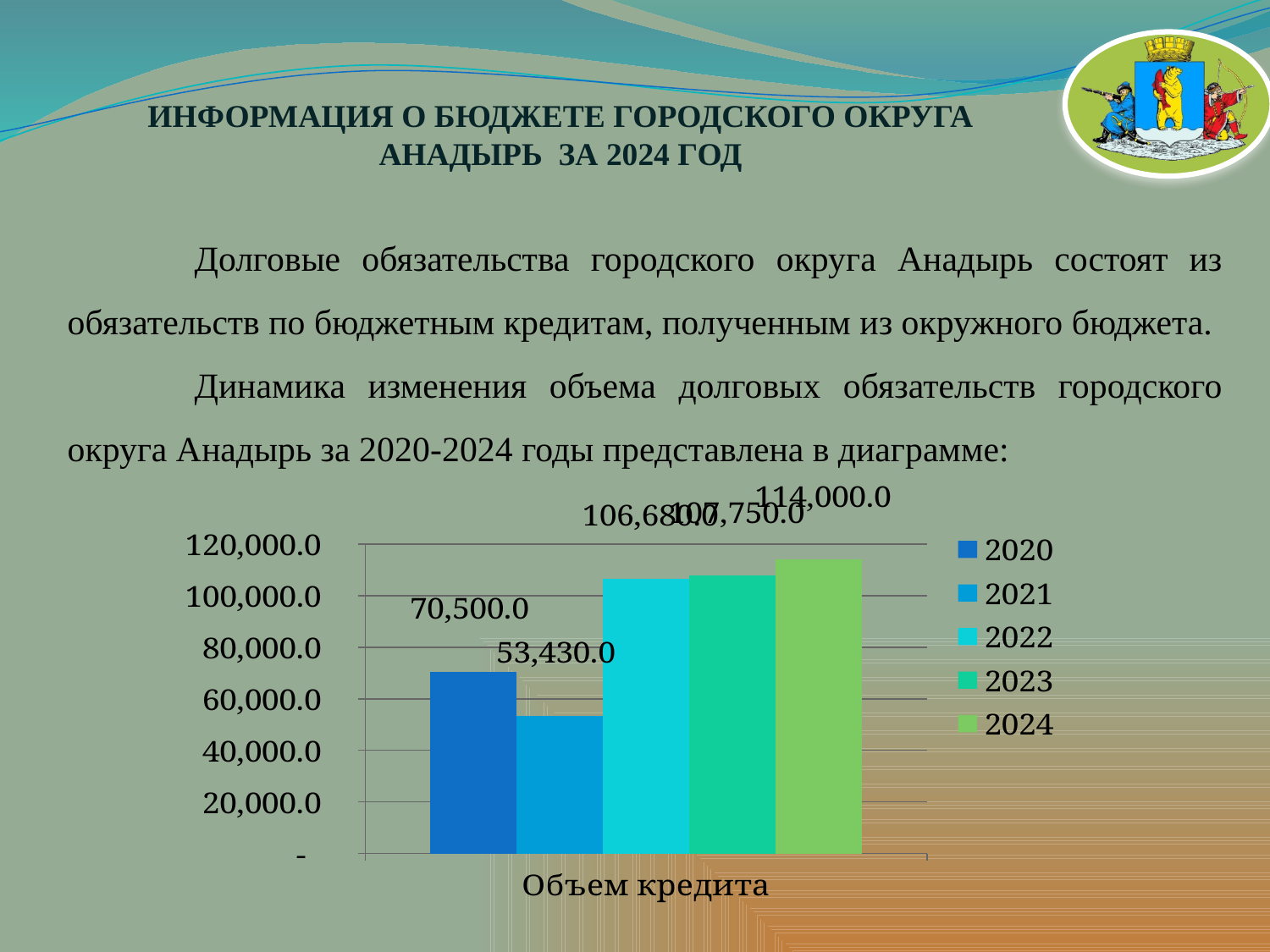
What is the difference between the values for 2020 and 2021? 17,070.0 What is the value for 2023? 107,750.0 Which year has the highest value? 2024 Is the value for 2021 greater or less than 60,000.0? less How many series does the legend list? 5 Which is larger, the value for 2020 or the value for 2021? 2020 Which year has the lowest value? 2021 What is the value for 2024? 114,000.0 What is the value for 2021? 53,430.0 What is the category label shown on the x axis? Объем кредита What is the value for 2020? 70,500.0 What kind of chart is shown on the slide? bar chart